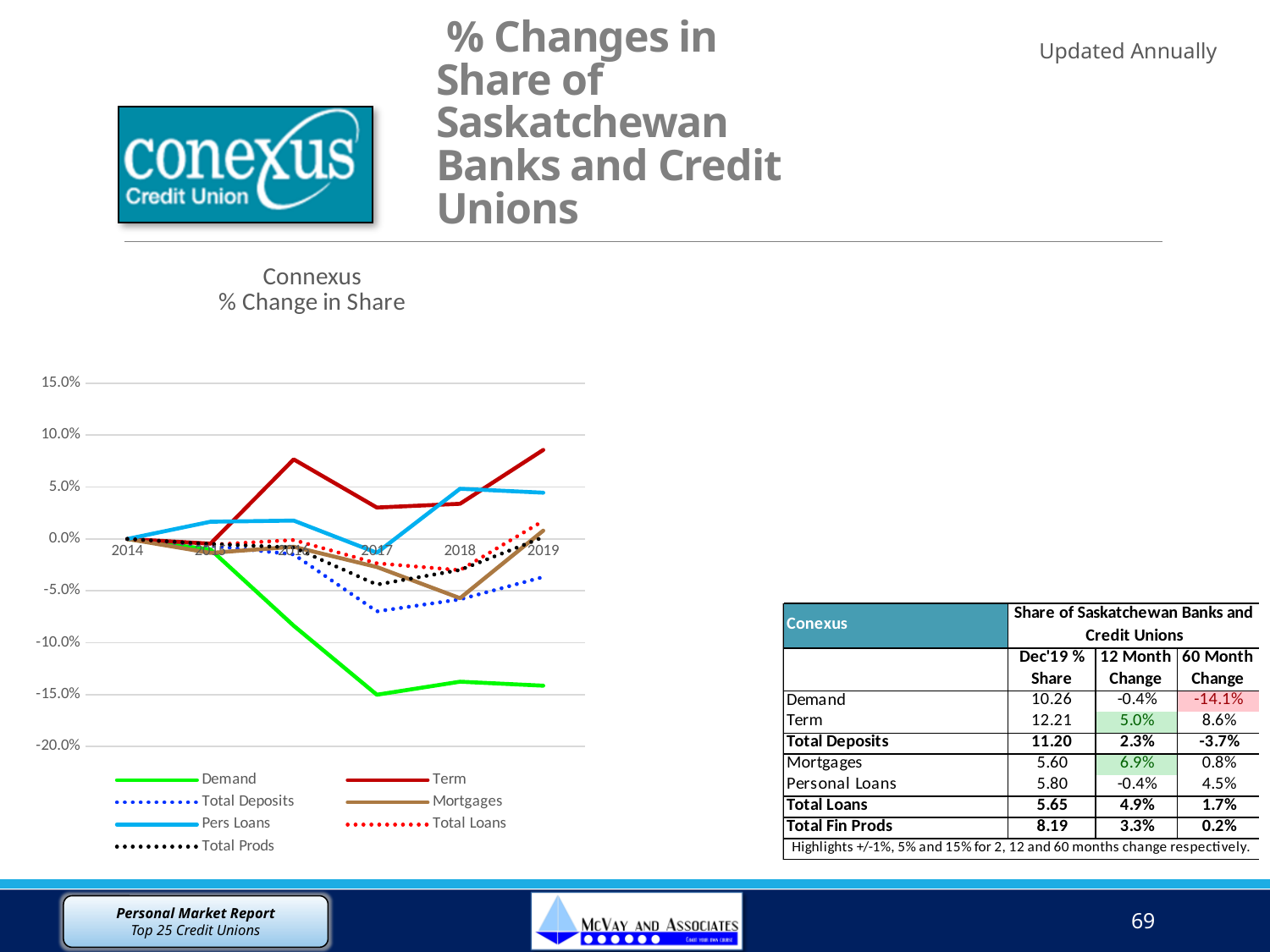
Does the Demand line rise or fall from 2014 to 2017? fall Which series has the lowest value in 2019? Demand Is the value for Demand in 2019 greater or less than -10.0%? less What is the title of the chart? Connexus % Change in Share Is the value for Demand in 2017 greater or less than -10.0%? less Is the value for Term in 2016 greater or less than 5.0%? greater What kind of chart is shown on the slide? line chart Which is larger in 2018, Pers Loans or Demand? Pers Loans How many series does the chart legend list? 7 How many years are shown along the x axis of the chart? 6 Which series has the highest value in 2019? Term